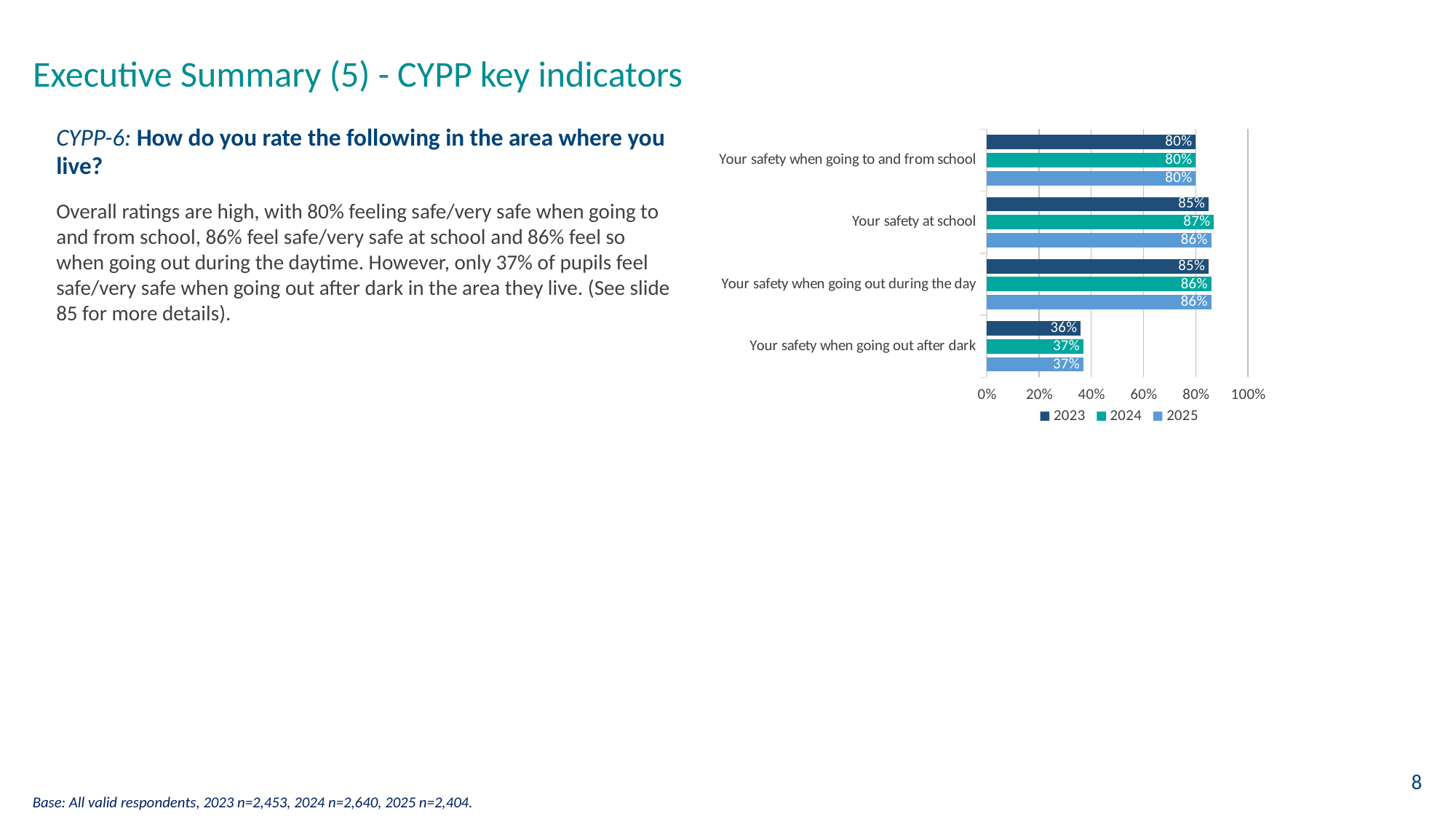
What kind of chart is shown on the slide? Bar chart What is the 2024 value for 'Your safety at school'? 87% Which is larger: the 2024 value for 'Your safety at school' or the 2024 value for 'Your safety when going out after dark'? Your safety at school How many series does the legend list? 3 What is the 2023 value for 'Your safety when going out after dark'? 36% Which category has the highest value in the 2024 series? Your safety at school What is the 2023 value for 'Your safety when going to and from school'? 80% Which category has the lowest value in the 2025 series? Your safety when going out after dark Which years are listed in the chart legend? 2023, 2024, 2025 How many categories are shown on the chart? 4 What is the 2025 value for 'Your safety when going out after dark'? 37% What is the difference between the 2025 values for 'Your safety at school' and 'Your safety when going out after dark'? 49 percentage points